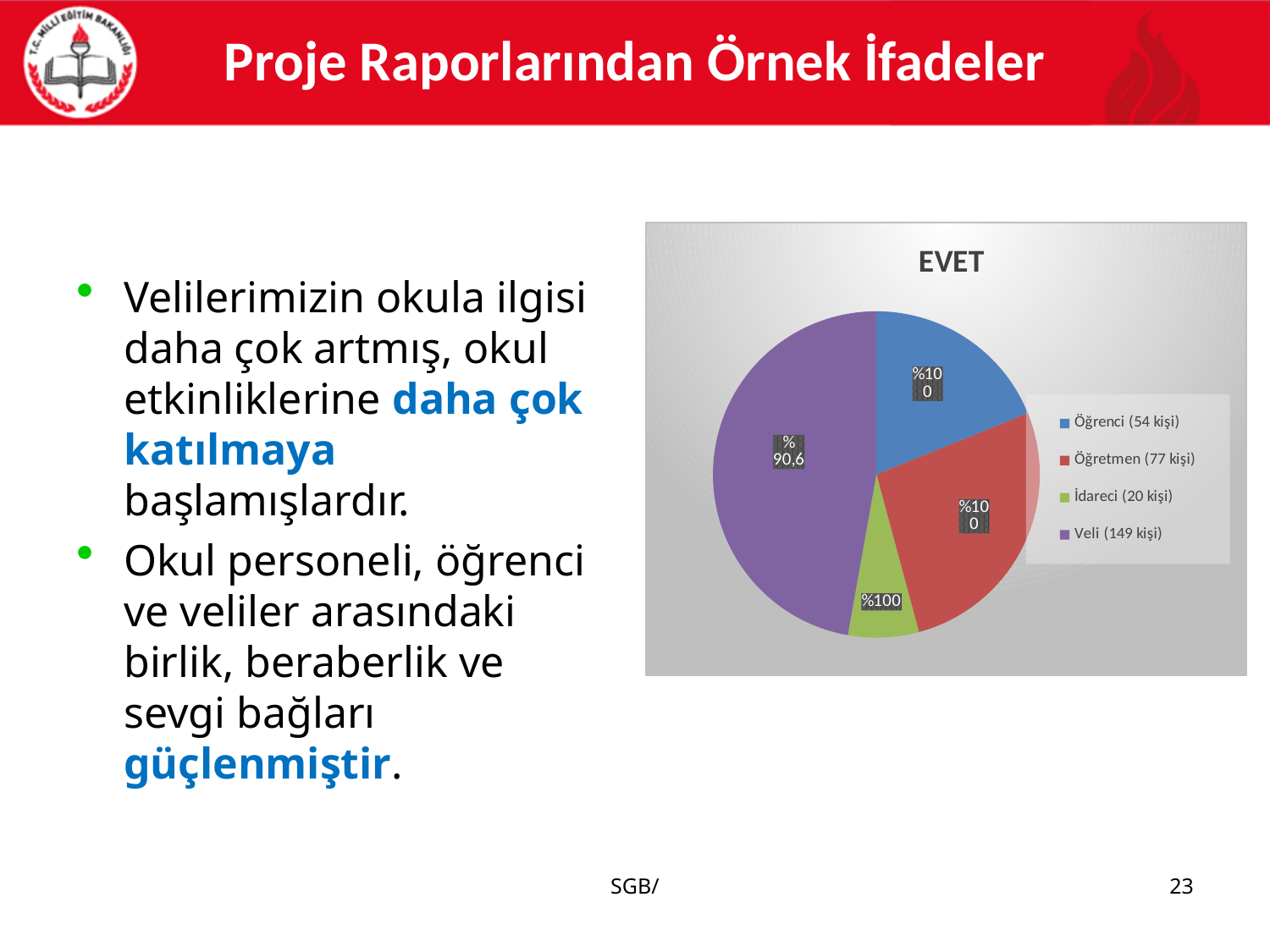
Which category has the largest slice in the pie chart? Veli (149 kişi) Which category has the smallest slice in the pie chart? İdareci (20 kişi) What data label is printed on the Öğrenci (54 kişi) slice of the pie chart? %100 What data label is printed on the Veli (149 kişi) slice of the pie chart? %90,6 What colour is the Veli (149 kişi) slice in the pie chart? Purple How many people does the legend give for the Veli category? 149 kişi Which slice is larger in the pie chart, Öğretmen (77 kişi) or Öğrenci (54 kişi)? Öğretmen (77 kişi) How many people does the legend give for the Öğretmen category? 77 kişi What is the title of the pie chart? EVET What kind of chart is shown on the slide? Pie chart How many categories does the pie chart's legend list? 4 What data label is printed on the İdareci (20 kişi) slice of the pie chart? %100